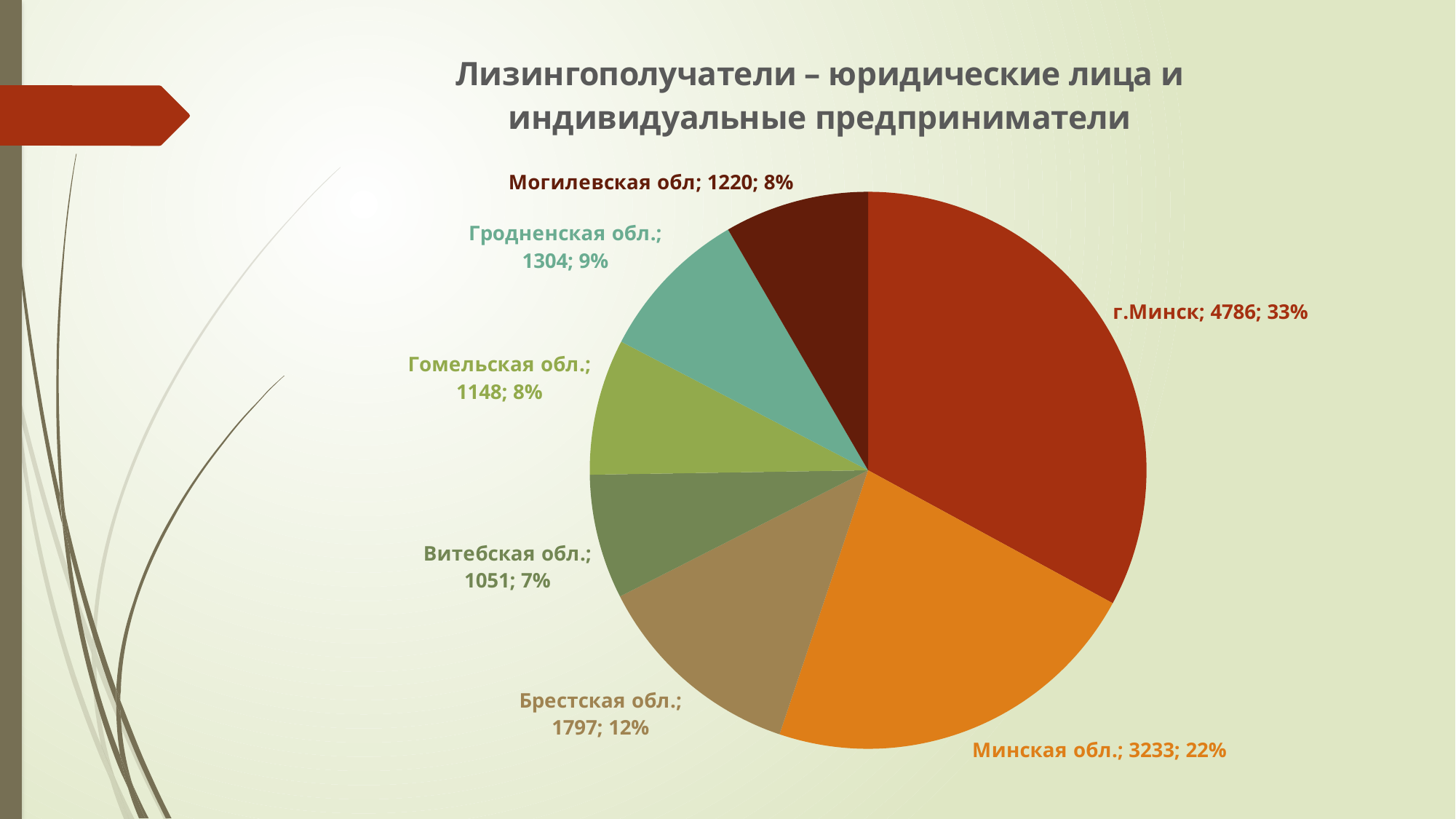
Which is larger, the value for Гродненская обл. or the value for Могилевская обл? Гродненская обл. Which category has the largest slice? г.Минск What is the difference between the values for г.Минск and Минская обл.? 1553 How many slices does the pie chart have? 7 What share of the pie does Гродненская обл. represent? 9% What is the title of the chart? Лизингополучатели – юридические лица и индивидуальные предприниматели What is the value for г.Минск? 4786 What is the value for Витебская обл.? 1051 What is the value for Брестская обл.? 1797 What type of chart is shown on the slide? pie chart What share of the pie does Минская обл. represent? 22% Which category has the smallest slice? Витебская обл.